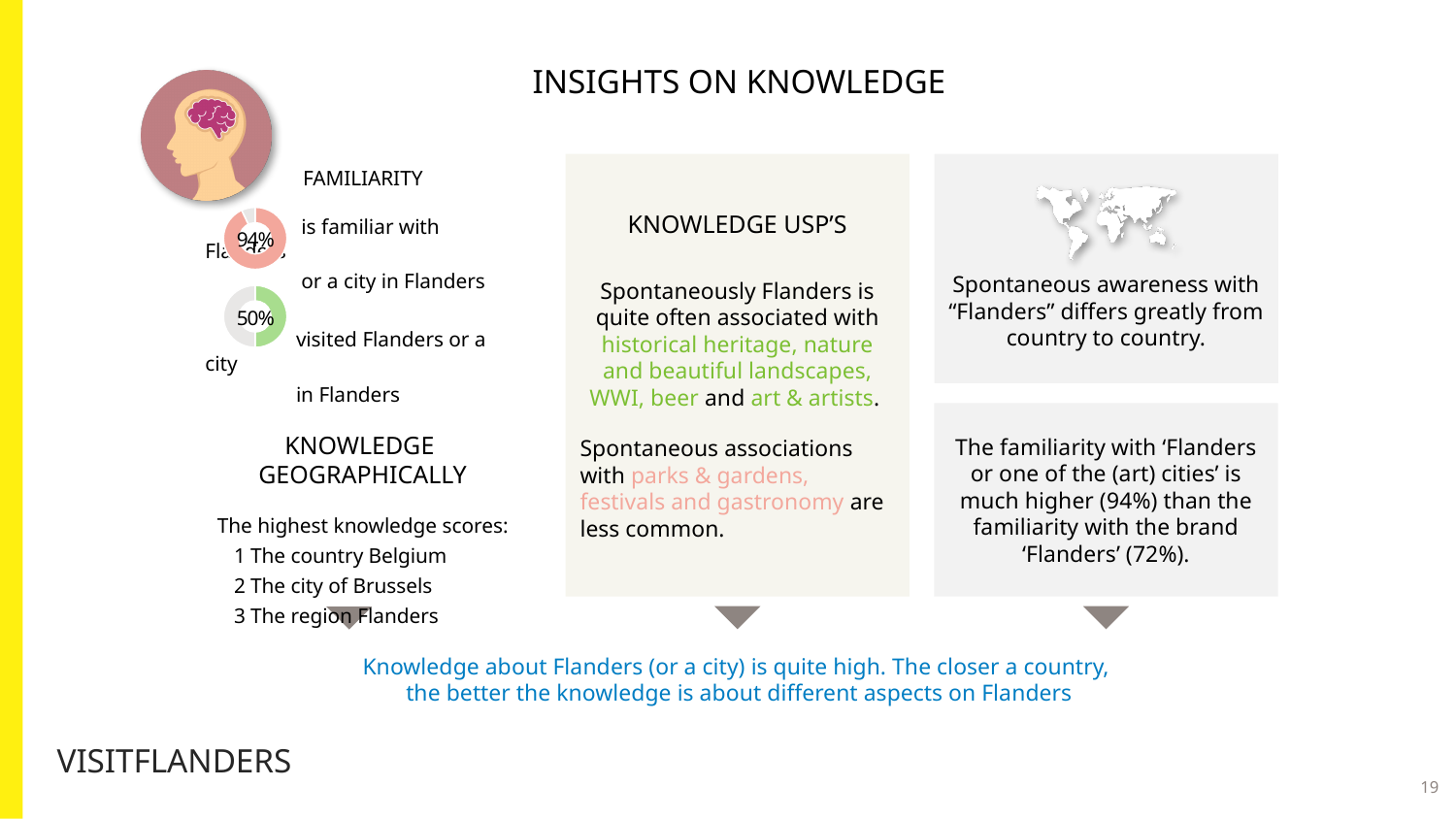
What percentage is shown for people who are familiar with Flanders or a city in Flanders? 94% How many doughnut charts are shown on the slide? 2 Which of the two doughnut charts shows the larger value, the top one (familiar with) or the bottom one (visited)? the top one (familiar with) What value is shown in the bottom doughnut chart under FAMILIARITY? 50% What kind of chart is used to display the 94% and 50% values on the slide? doughnut chart What is the difference in percentage points between the top doughnut value (94%) and the bottom doughnut value (50%)? 44 percentage points What colour is the filled portion of the top doughnut chart showing 94%? pink/red What colour is the filled portion of the bottom doughnut chart showing 50%? green What value is shown in the top doughnut chart under FAMILIARITY? 94% What percentage is shown for people who visited Flanders or a city in Flanders? 50%